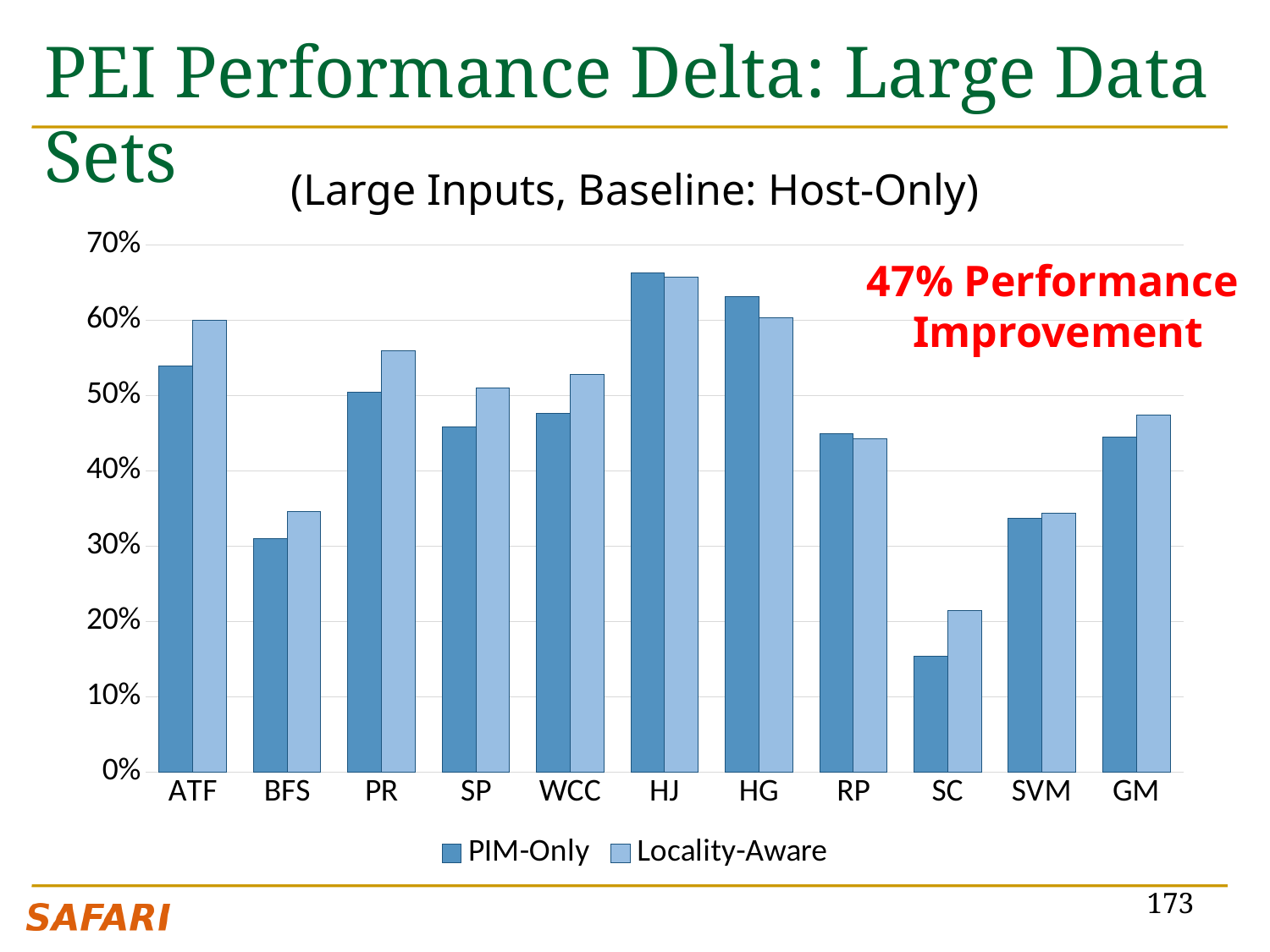
For HG, which is larger: the PIM-Only value or the Locality-Aware value? PIM-Only How many categories are shown on the x axis? 11 For SC, which is larger: the PIM-Only value or the Locality-Aware value? Locality-Aware Is the PIM-Only value for BFS greater or less than 40%? less What are the two series named in the legend? PIM-Only and Locality-Aware Which category has the lowest Locality-Aware value? SC Is the Locality-Aware value for HJ greater or less than 60%? greater Which category has the lowest PIM-Only value? SC Which category has the highest PIM-Only value? HJ How many series does the legend list? 2 Is the PIM-Only value for SC greater or less than 20%? less What kind of chart is shown on the slide? bar chart